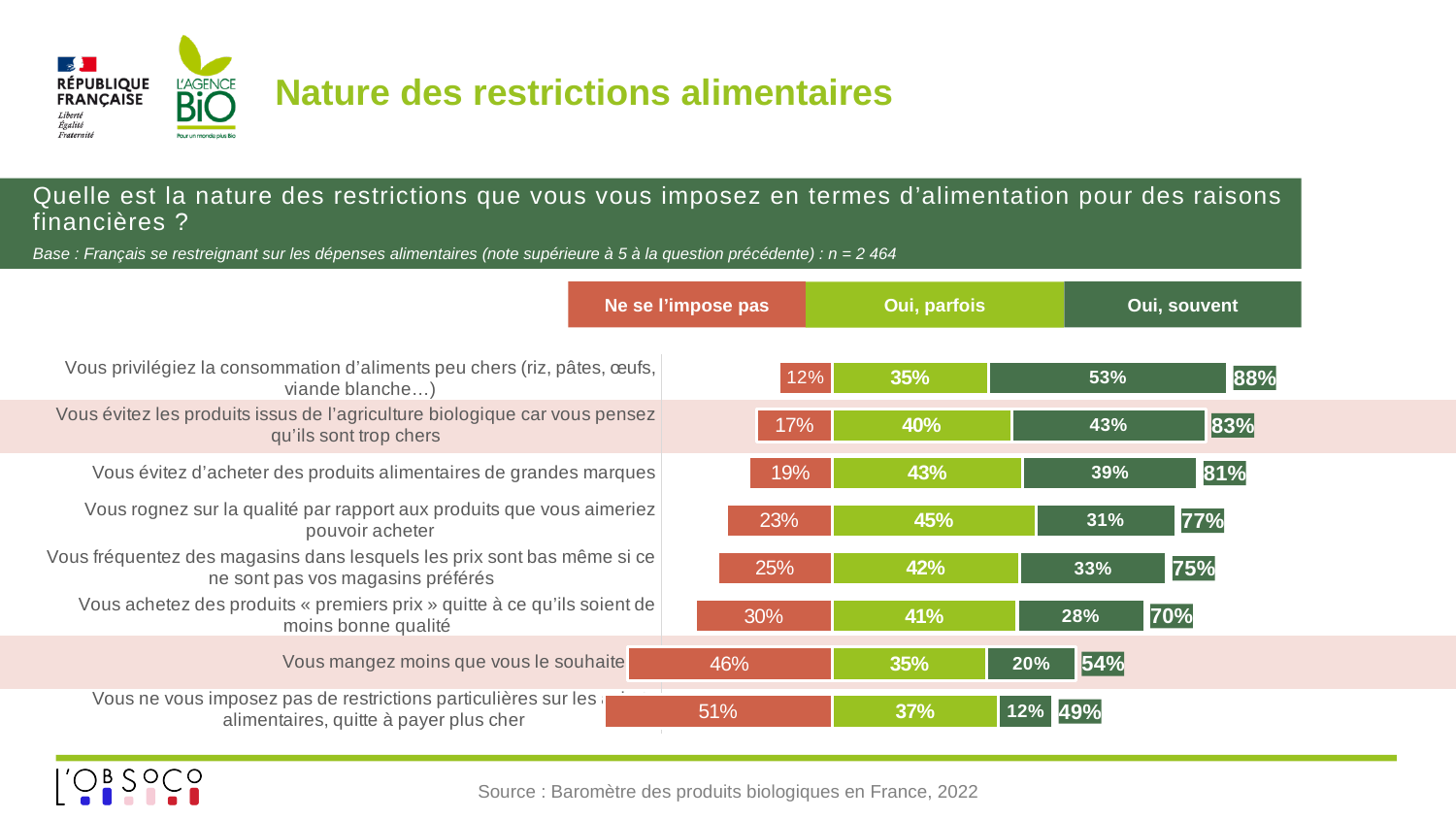
Which category has the highest "Ne se l'impose pas" value? Vous ne vous imposez pas de restrictions particulières sur les achats alimentaires, quitte à payer plus cher What is the source cited at the bottom of the slide? Baromètre des produits biologiques en France, 2022 Which category has the lowest "Oui, souvent" value? Vous ne vous imposez pas de restrictions particulières sur les achats alimentaires, quitte à payer plus cher What is the "Oui, souvent" value for "Vous privilégiez la consommation d'aliments peu chers (riz, pâtes, œufs, viande blanche…)"? 53% What is the difference between the "Oui, souvent" values for "Vous privilégiez la consommation d'aliments peu chers" and "Vous évitez d'acheter des produits alimentaires de grandes marques"? 14% Which is larger: the "Oui, parfois" value for "Vous évitez d'acheter des produits alimentaires de grandes marques" or for "Vous achetez des produits « premiers prix » quitte à ce qu'ils soient de moins bonne qualité"? Vous évitez d'acheter des produits alimentaires de grandes marques What is the combined "Oui, parfois" and "Oui, souvent" total shown for "Vous fréquentez des magasins dans lesquels les prix sont bas même si ce ne sont pas vos magasins préférés"? 75% What is the "Ne se l'impose pas" value for "Vous mangez moins que vous le souhaite"? 46% How many series does the legend list? 3 What kind of chart is shown on the slide? Stacked bar chart What is the "Oui, parfois" value for "Vous rognez sur la qualité par rapport aux produits que vous aimeriez pouvoir acheter"? 45% How many categories (statements) are shown in the chart? 8